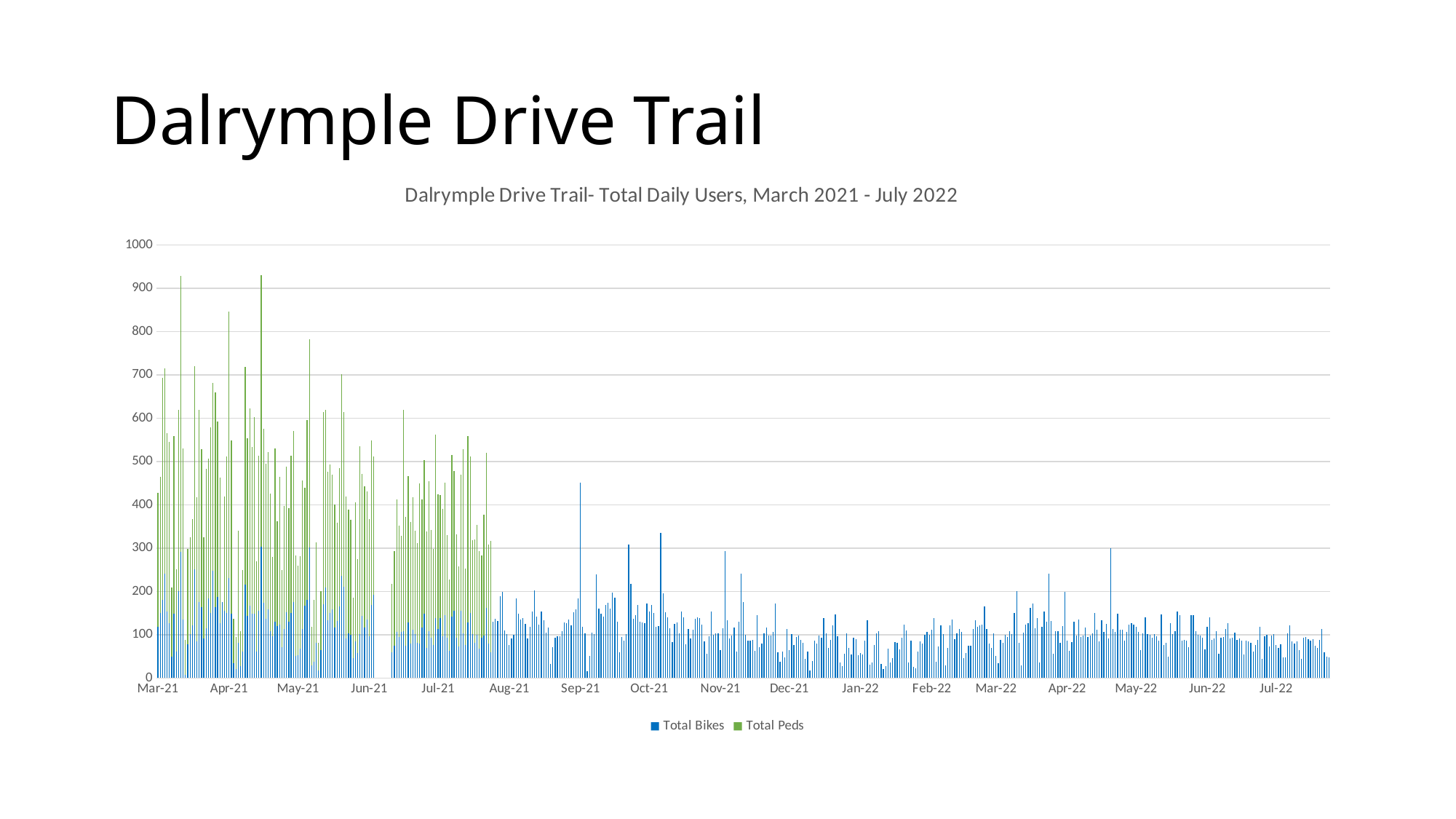
Which series is shown in green? Total Peds Is the highest Total Bikes value in Oct-21 greater or less than 400? less Which month label is last on the x axis? Jul-22 How many month labels are shown on the x axis? 17 How many series does the legend list? 2 What is the highest value shown on the y axis? 1000 Which month label is first on the x axis? Mar-21 What type of chart is shown on the slide? Bar chart Do the Total Peds values in Mar-21 to Jul-21 tend to be higher or lower than the Total Bikes values in the same period? higher What is the title of the chart? Dalrymple Drive Trail- Total Daily Users, March 2021 - July 2022 Which series reaches higher values in Apr-21, Total Bikes or Total Peds? Total Peds